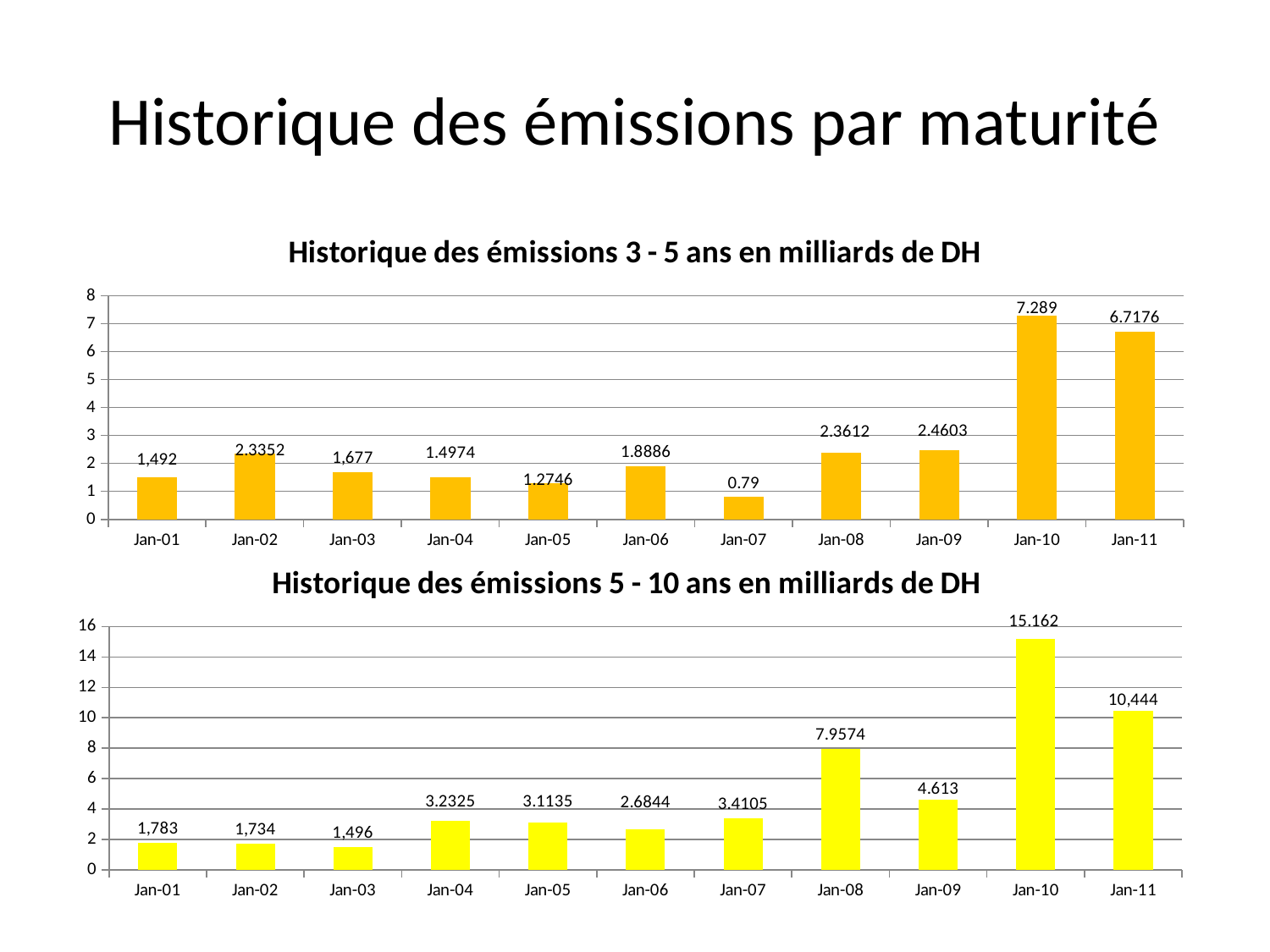
In the chart 'Historique des émissions 5 - 10 ans en milliards de DH', which category has the lowest value? Jan-03 In the chart 'Historique des émissions 3 - 5 ans en milliards de DH', what is the value for Jan-07? 0.79 In the chart 'Historique des émissions 3 - 5 ans en milliards de DH', what is the value for Jan-10? 7.289 In the chart 'Historique des émissions 3 - 5 ans en milliards de DH', which category has the highest value? Jan-10 In the chart 'Historique des émissions 5 - 10 ans en milliards de DH', what is the value for Jan-10? 15.162 In the chart 'Historique des émissions 5 - 10 ans en milliards de DH', which is larger, the value for Jan-04 or the value for Jan-06? Jan-04 How many categories are shown on the x axis of the chart 'Historique des émissions 5 - 10 ans en milliards de DH'? 11 In the chart 'Historique des émissions 3 - 5 ans en milliards de DH', which category has the lowest value? Jan-07 In the chart 'Historique des émissions 3 - 5 ans en milliards de DH', what is the difference between the values for Jan-10 and Jan-11? 0.5714 In the chart 'Historique des émissions 5 - 10 ans en milliards de DH', what is the difference between the values for Jan-08 and Jan-09? 3.3444 In the chart 'Historique des émissions 5 - 10 ans en milliards de DH', what is the value for Jan-08? 7.9574 What type of chart is the top chart on the slide? Bar chart